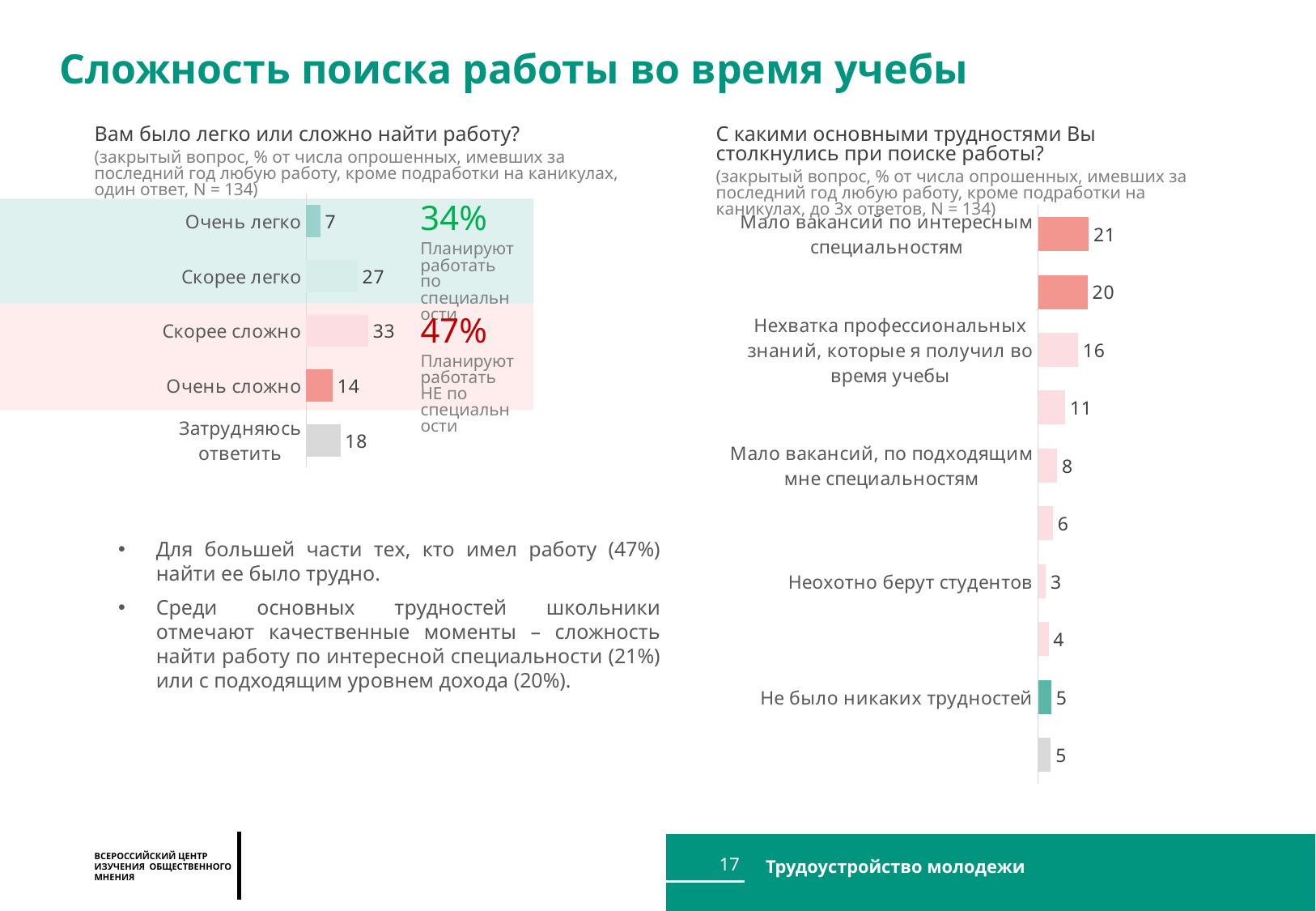
In the right chart 'С какими основными трудностями Вы столкнулись при поиске работы?', what is the value for 'Нехватка профессиональных знаний, которые я получил во время учебы'? 16 In the left chart 'Вам было легко или сложно найти работу?', what is the value for 'Очень легко'? 7 In the right chart 'С какими основными трудностями Вы столкнулись при поиске работы?', what is the value for 'Мало вакансий по интересным специальностям'? 21 What type of chart is the left chart 'Вам было легко или сложно найти работу?'? Bar chart In the right chart 'С какими основными трудностями Вы столкнулись при поиске работы?', what is the value for 'Неохотно берут студентов'? 3 In the right chart 'С какими основными трудностями Вы столкнулись при поиске работы?', how many bars are plotted? 10 In the left chart 'Вам было легко или сложно найти работу?', what is the difference between 'Скорее легко' and 'Очень сложно'? 13 In the left chart 'Вам было легко или сложно найти работу?', which category has the highest value? Скорее сложно In the right chart 'С какими основными трудностями Вы столкнулись при поиске работы?', which is larger: 'Мало вакансий, по подходящим мне специальностям' or 'Не было никаких трудностей'? Мало вакансий, по подходящим мне специальностям In the left chart 'Вам было легко или сложно найти работу?', how many categories are shown? 5 In the left chart 'Вам было легко или сложно найти работу?', which category has the lowest value? Очень легко In the left chart 'Вам было легко или сложно найти работу?', what is the value for 'Скорее сложно'? 33